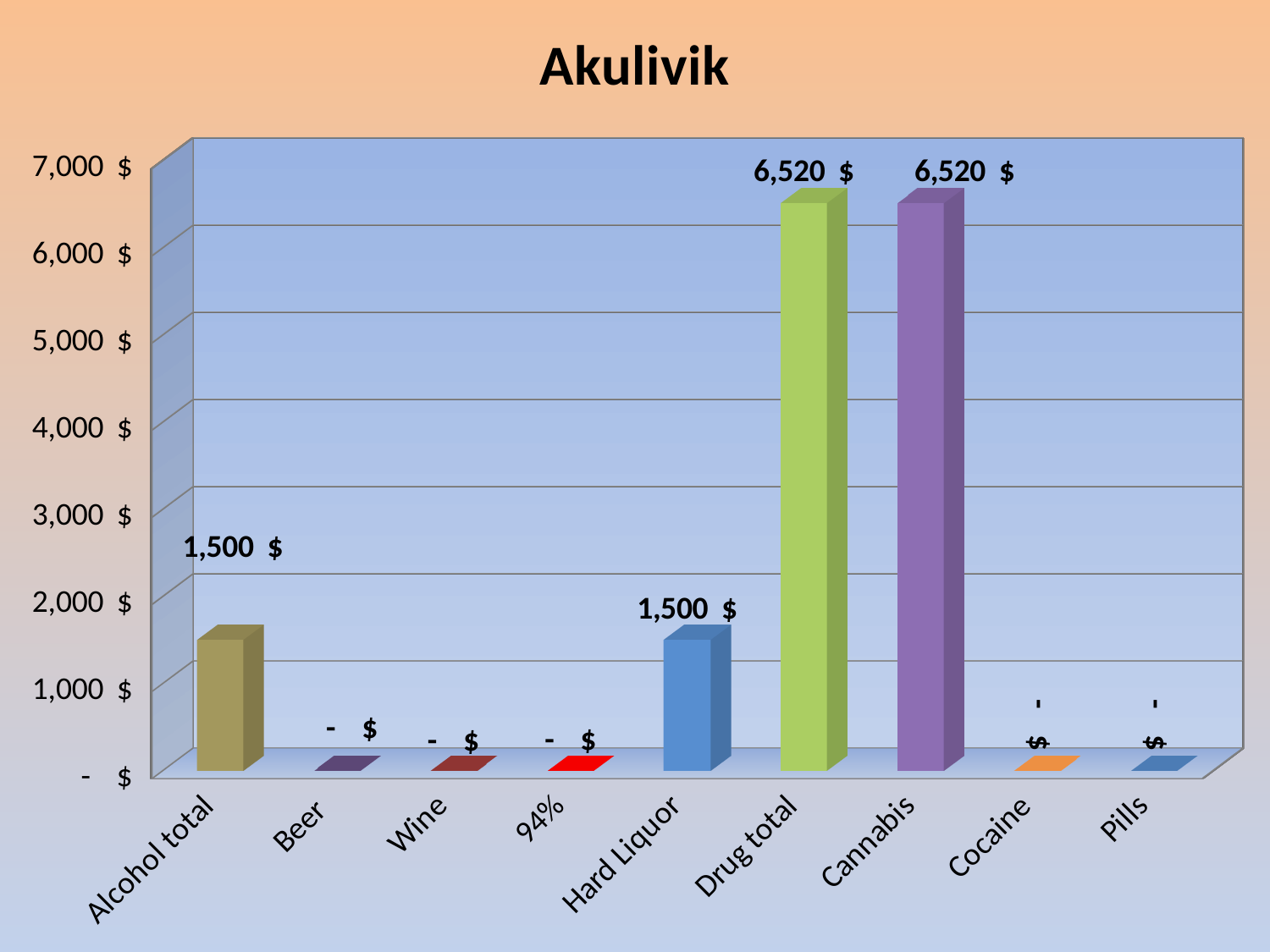
What is the value for Hard Liquor? 1,500 $ What is the value for Cannabis? 6,520 $ Which is larger, the value for Drug total or the value for Alcohol total? Drug total What kind of chart is shown on the slide? bar chart Is the value for Cannabis greater or less than 6,000? greater What is the value for Drug total? 6,520 $ What is the title of the chart? Akulivik Is the value for Alcohol total greater or less than 2,000? less What is the difference between the Drug total and the Alcohol total? 5,020 $ How many categories are shown on the x axis? 9 What is the value for Alcohol total? 1,500 $ What is the value shown for Beer? - $